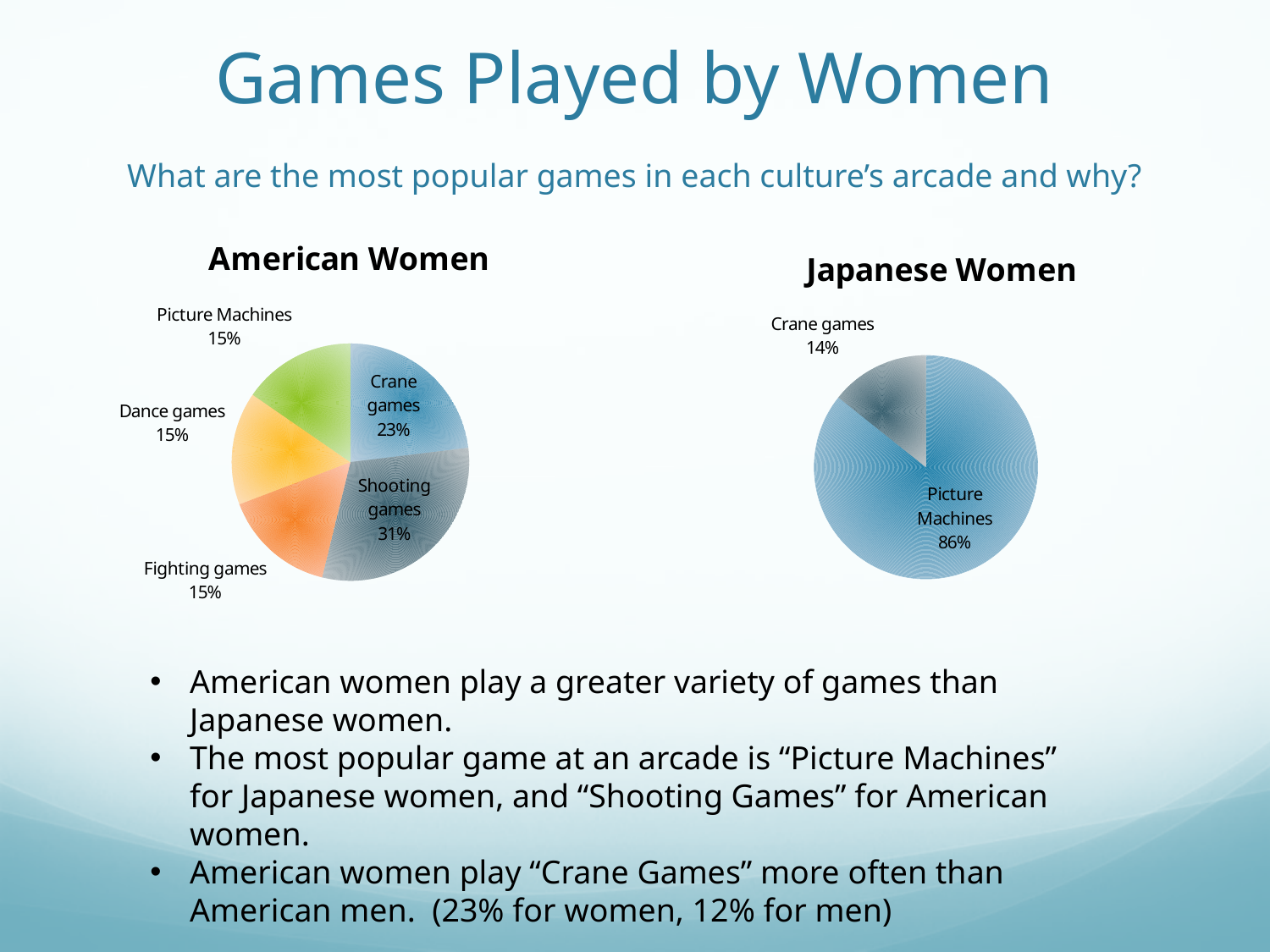
In the Japanese Women chart, what percentage is Picture Machines? 86% In the American Women chart, which category has the largest share? Shooting games In the Japanese Women chart, what percentage is Crane games? 14% Which is larger: Crane games for American Women or Crane games for Japanese Women? American Women In the Japanese Women chart, which category has the smallest share? Crane games In the American Women chart, what percentage is Shooting games? 31% In the American Women chart, what percentage is Crane games? 23% In the Japanese Women chart, what is the difference between Picture Machines and Crane games? 72% How many categories are shown in the American Women chart? 5 How many categories are shown in the Japanese Women chart? 2 In the American Women chart, what is the difference between Shooting games and Crane games? 8% What type of chart is the American Women chart? Pie chart